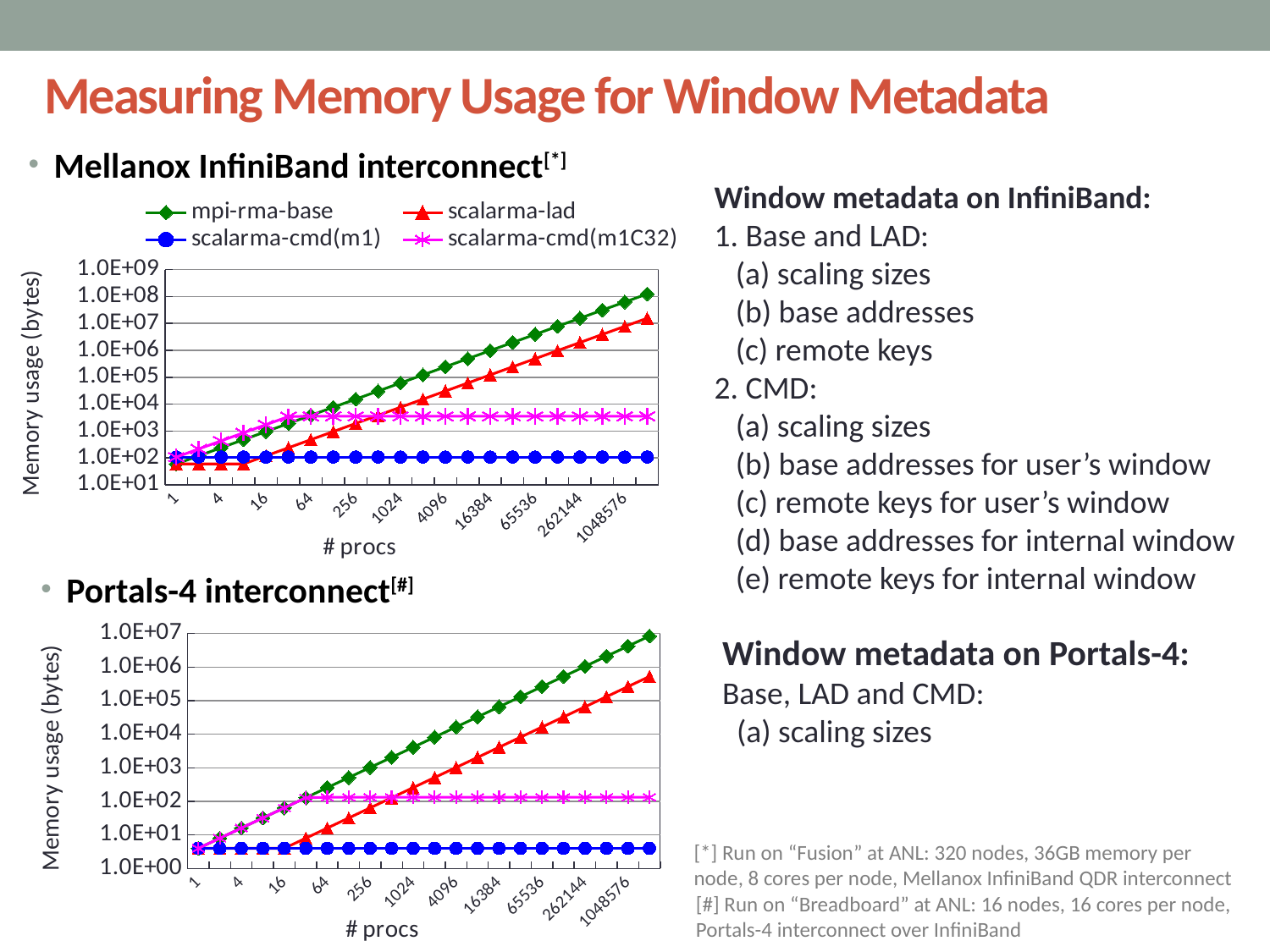
In the Mellanox InfiniBand interconnect chart, is the memory usage of mpi-rma-base at 1048576 procs greater or less than 1.0E+07? greater In the Portals-4 interconnect chart, is the memory usage of mpi-rma-base at 1048576 procs greater or less than 1.0E+06? greater In the Portals-4 interconnect chart, is the memory usage of scalarma-cmd(m1) at 1048576 procs greater or less than 1.0E+01? less In the Portals-4 interconnect chart, which is larger at 1048576 procs: the memory usage of mpi-rma-base or of scalarma-lad? mpi-rma-base What is the label of the x axis in the Portals-4 interconnect chart? # procs What are the series names listed in the legend of the Mellanox InfiniBand interconnect chart? mpi-rma-base, scalarma-lad, scalarma-cmd(m1), scalarma-cmd(m1C32) How many series does the legend of the Mellanox InfiniBand interconnect chart list? 4 In the Mellanox InfiniBand interconnect chart, which series has the lowest memory usage at 1048576 procs? scalarma-cmd(m1) In the Mellanox InfiniBand interconnect chart, does the memory usage of mpi-rma-base rise or fall as the number of procs increases? rise In the Mellanox InfiniBand interconnect chart, which series has the highest memory usage at 1048576 procs? mpi-rma-base What kind of chart is the Mellanox InfiniBand interconnect chart? line chart